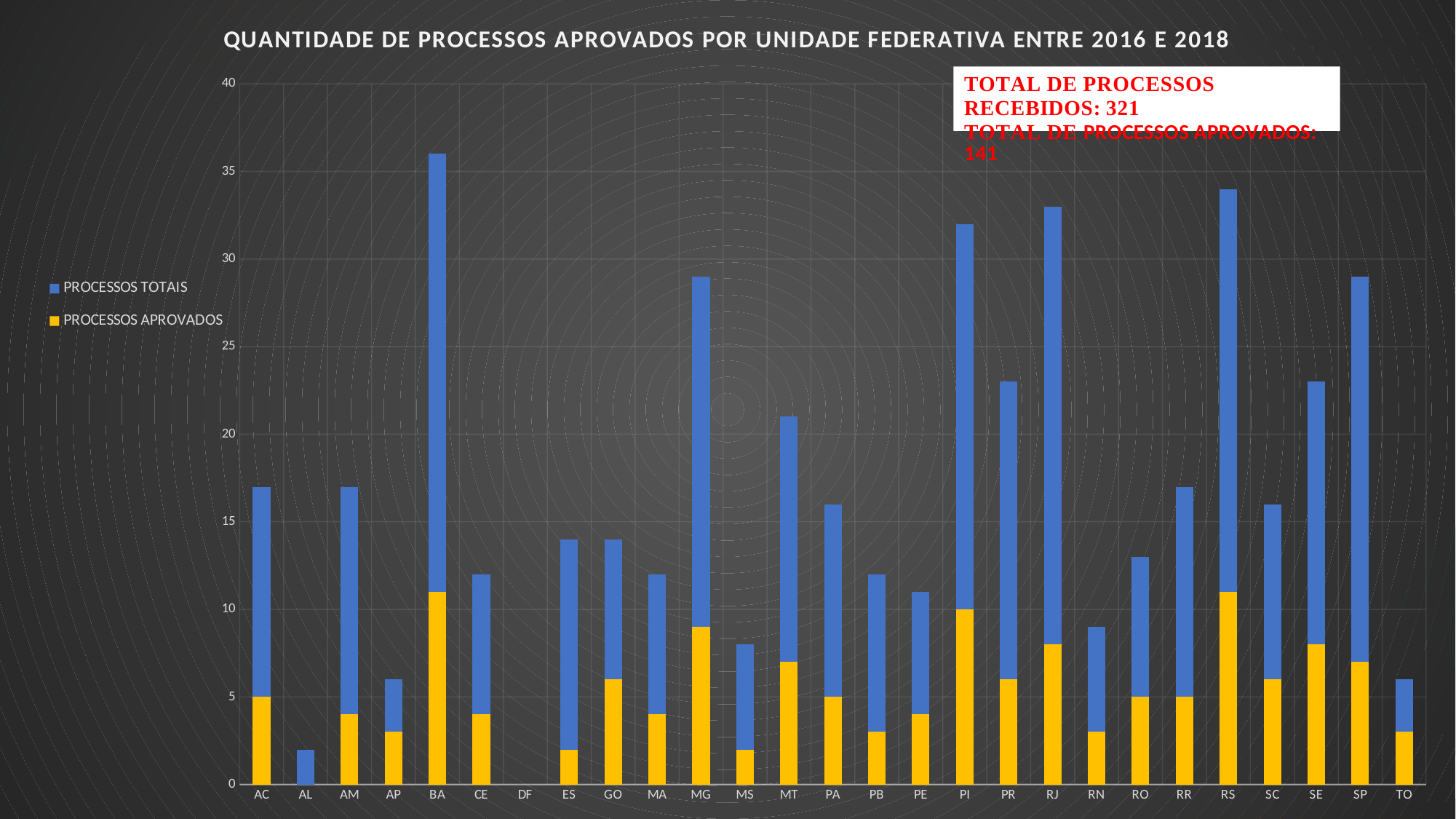
What are the two series named in the legend? PROCESSOS TOTAIS and PROCESSOS APROVADOS What kind of chart is shown on the slide? bar chart Which has the larger PROCESSOS TOTAIS value, BA or SP? BA Which federative unit has the lowest value for PROCESSOS TOTAIS? DF Is the PROCESSOS TOTAIS value for AL greater or less than 5? less Which has the larger PROCESSOS TOTAIS value, RS or PR? RS How many series does the legend list? 2 According to the text box on the slide, what is the total number of processes received (TOTAL DE PROCESSOS RECEBIDOS)? 321 How many federative units (categories) are shown on the x axis? 27 Is the PROCESSOS TOTAIS value for RJ greater or less than 30? less Is the PROCESSOS TOTAIS value for BA greater or less than 35? less